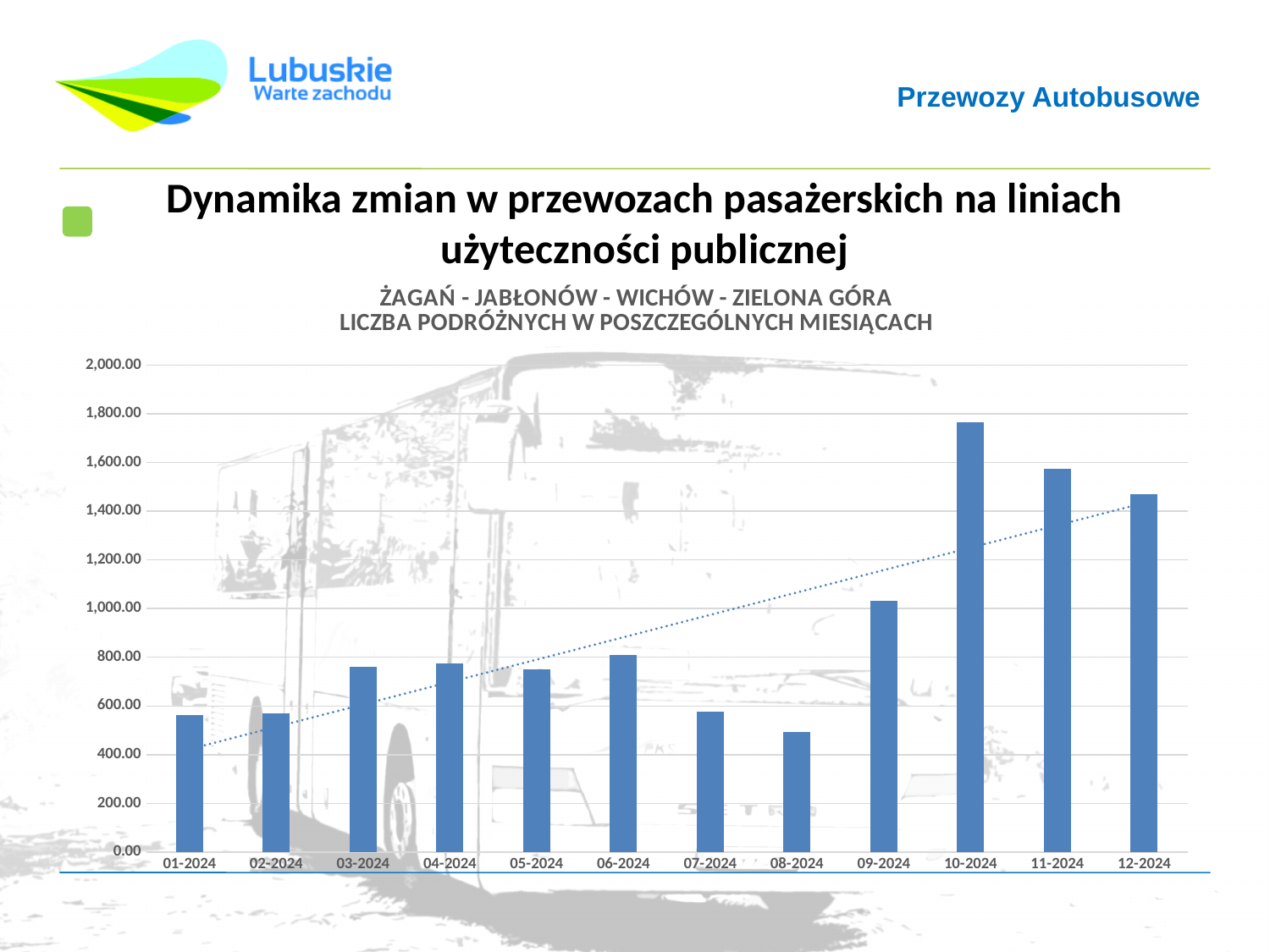
Is the value for 08-2024 greater or less than 600? less Is the value for 09-2024 greater or less than 800? greater According to the dotted trend line, do the values generally rise or fall over the months of 2024? rise Is the value for 10-2024 greater or less than 1,600? greater Which route is named in the chart's subtitle? ŻAGAŃ - JABŁONÓW - WICHÓW - ZIELONA GÓRA Which month has the lowest number of passengers? 08-2024 Which is larger, the value for 03-2024 or the value for 01-2024? 03-2024 Which is larger, the value for 11-2024 or the value for 12-2024? 11-2024 Which month has the highest number of passengers? 10-2024 How many months (categories) are plotted on the x axis? 12 What kind of chart is shown on the slide? bar chart